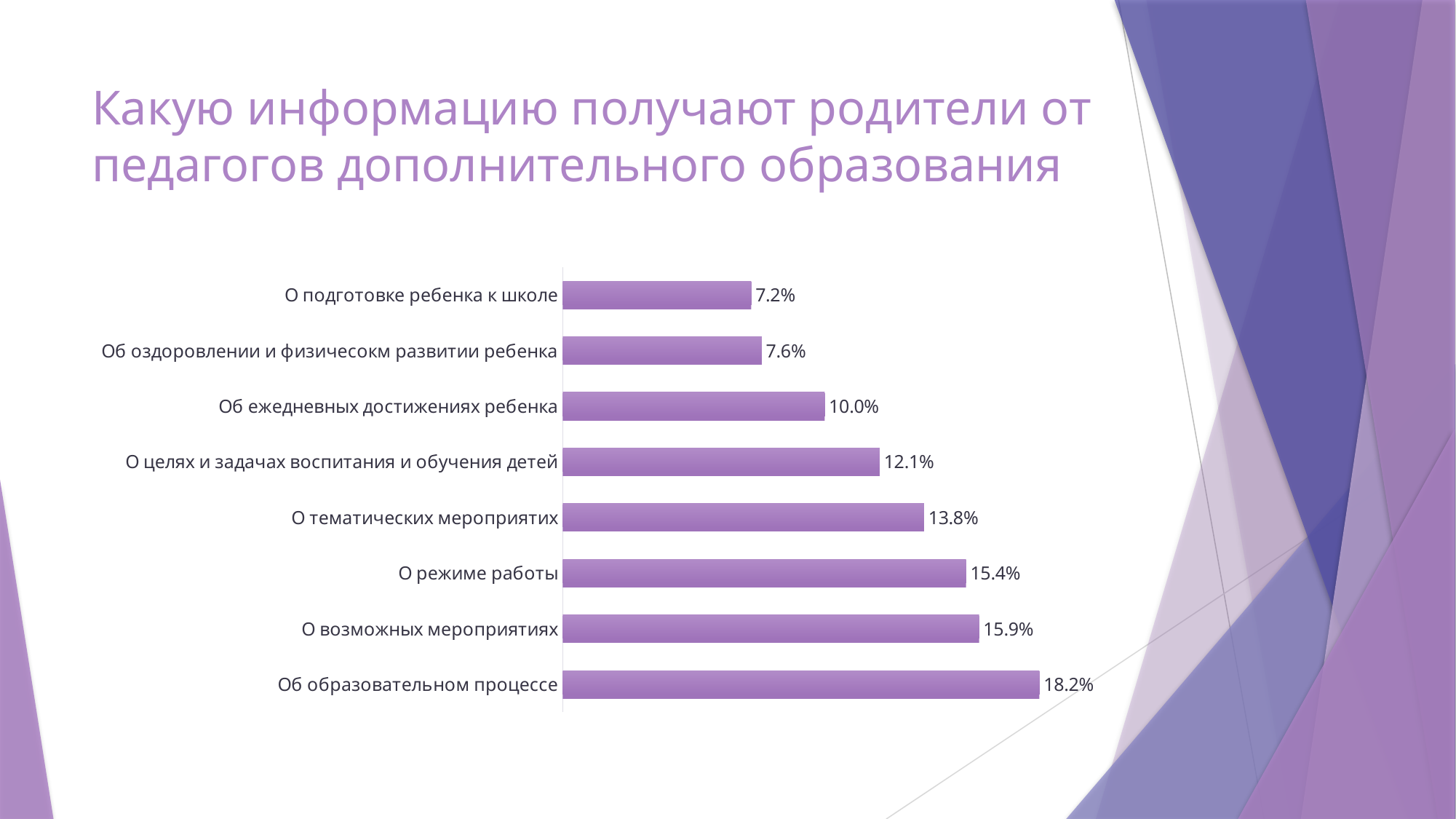
What is the value for "Об ежедневных достижениях ребенка"? 10.0% What is the value for "О подготовке ребенка к школе"? 7.2% What is the title of the slide? Какую информацию получают родители от педагогов дополнительного образования What is the value for "О тематических мероприятих"? 13.8% Which is larger: the value for "О возможных мероприятиях" or the value for "О тематических мероприятих"? О возможных мероприятиях What is the difference between the values for "О режиме работы" and "О целях и задачах воспитания и обучения детей"? 3.3% Which category has the highest value? Об образовательном процессе What is the difference between the values for "Об образовательном процессе" and "О подготовке ребенка к школе"? 11.0% Which category has the lowest value? О подготовке ребенка к школе How many categories are shown in the chart? 8 What is the value for "Об образовательном процессе"? 18.2% What kind of chart is shown on the slide? Bar chart